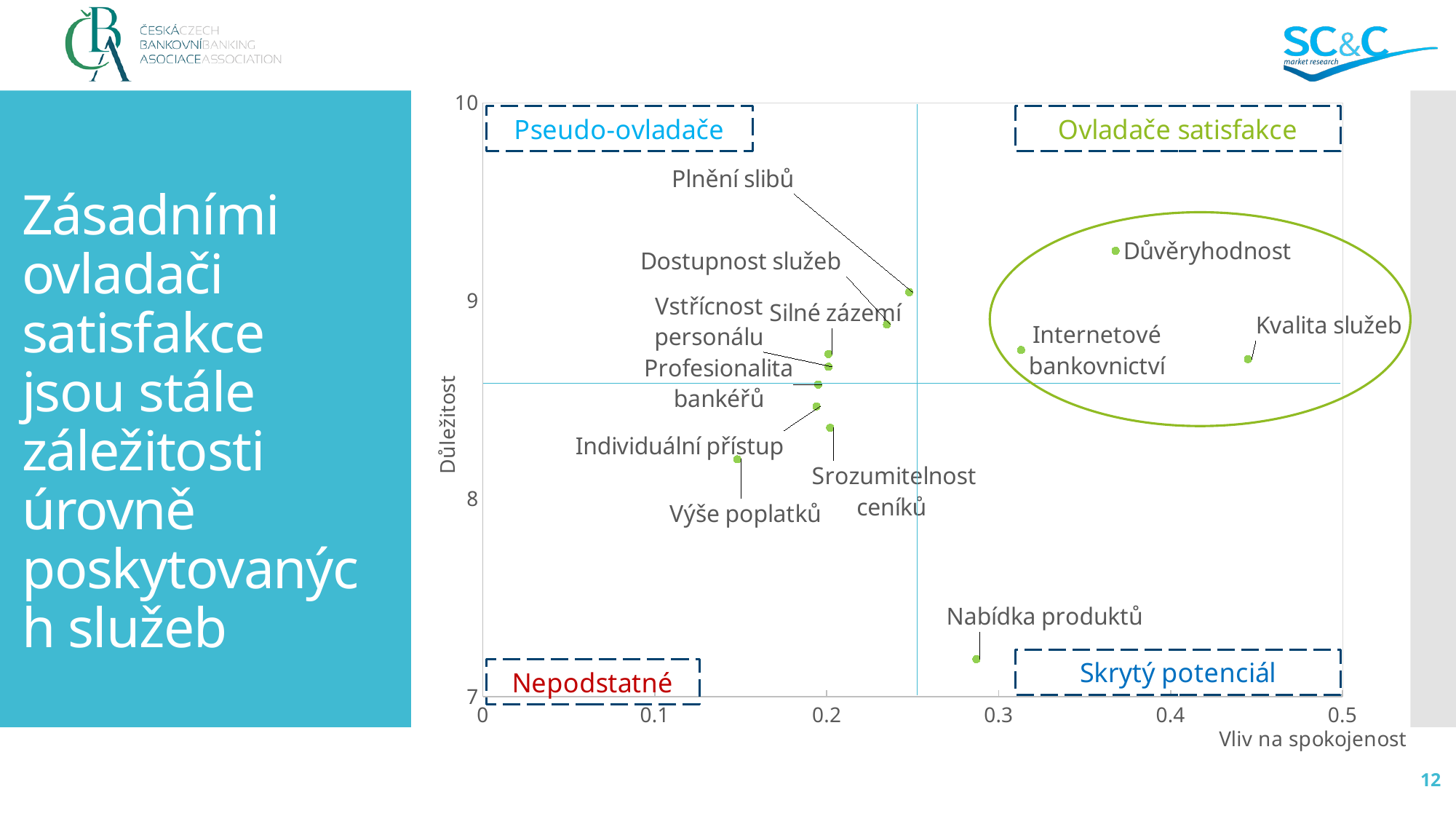
Which point has the lowest value on the Důležitost (vertical) axis? Nabídka produktů Which has the higher Důležitost value, Důvěryhodnost or Kvalita služeb? Důvěryhodnost Which point has the highest value on the Důležitost (vertical) axis? Důvěryhodnost Is the Důležitost value for Nabídka produktů greater or less than 8? less What is the label of the upper-right quadrant of the chart? Ovladače satisfakce Which point has the lowest value on the Vliv na spokojenost (horizontal) axis? Výše poplatků Is the Vliv na spokojenost value for Výše poplatků greater or less than 0.2? less How many data points are plotted on the chart? 12 Is the Důležitost value for Důvěryhodnost greater or less than 9? greater Which point has the highest value on the Vliv na spokojenost (horizontal) axis? Kvalita služeb What kind of chart is shown on the slide? scatter chart